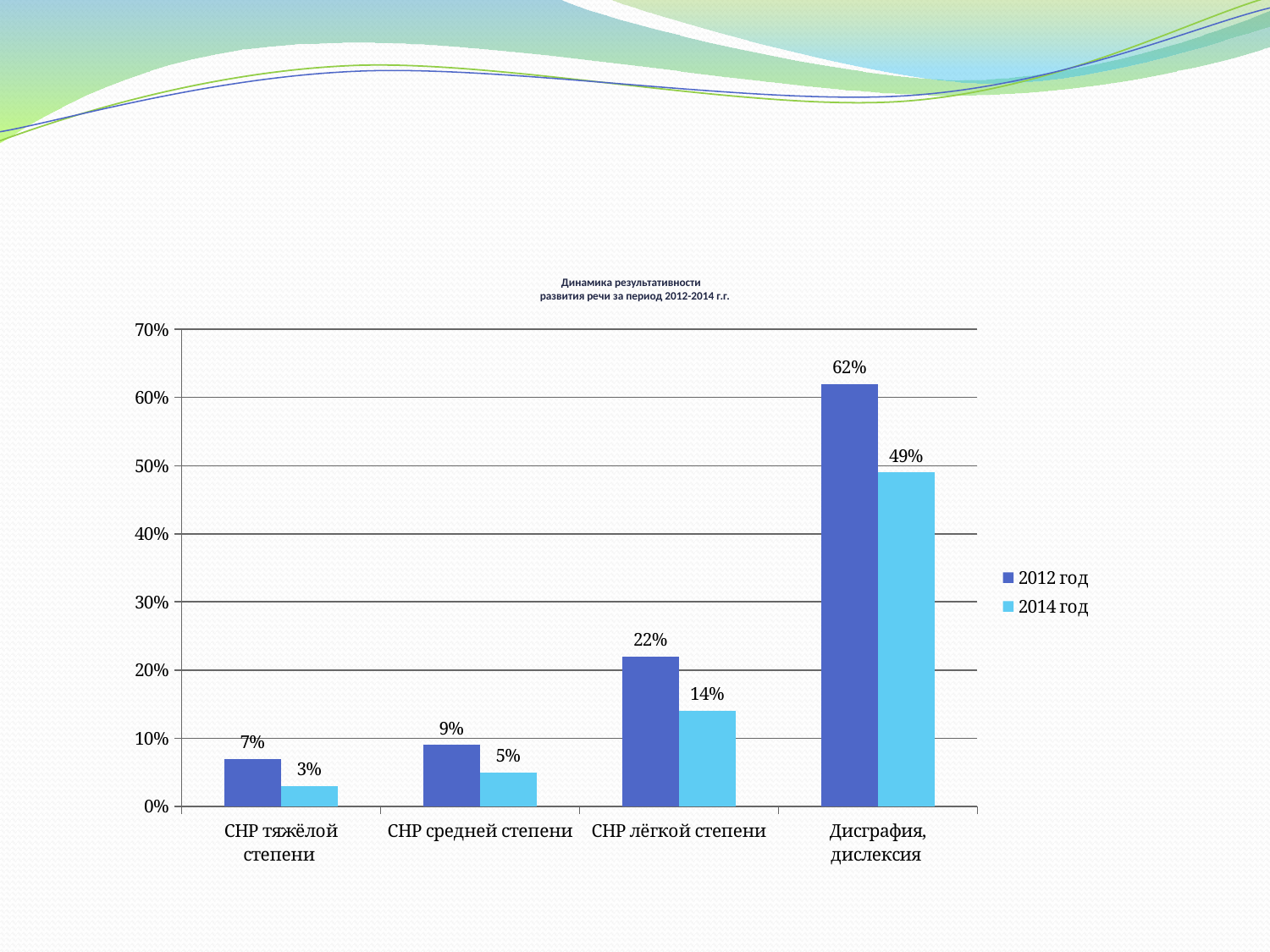
Is the 2014 год value for Дисграфия, дислексия greater or less than 50%? less Which category has the highest value for 2012 год? Дисграфия, дислексия How many series does the legend list? 2 What is the value for 2012 год in the Дисграфия, дислексия category? 62% Which is larger: the 2012 год value for СНР средней степени or the 2014 год value for СНР лёгкой степени? 2014 год value for СНР лёгкой степени How many categories are shown on the x axis? 4 What is the value for 2014 год in the СНР тяжёлой степени category? 3% Do the 2012 год values rise or fall from left to right along the x axis? rise Which category has the lowest value for 2014 год? СНР тяжёлой степени What kind of chart is shown on the slide? bar chart What is the difference between the 2012 год and 2014 год values for Дисграфия, дислексия? 13% What is the value for 2014 год in the СНР лёгкой степени category? 14%